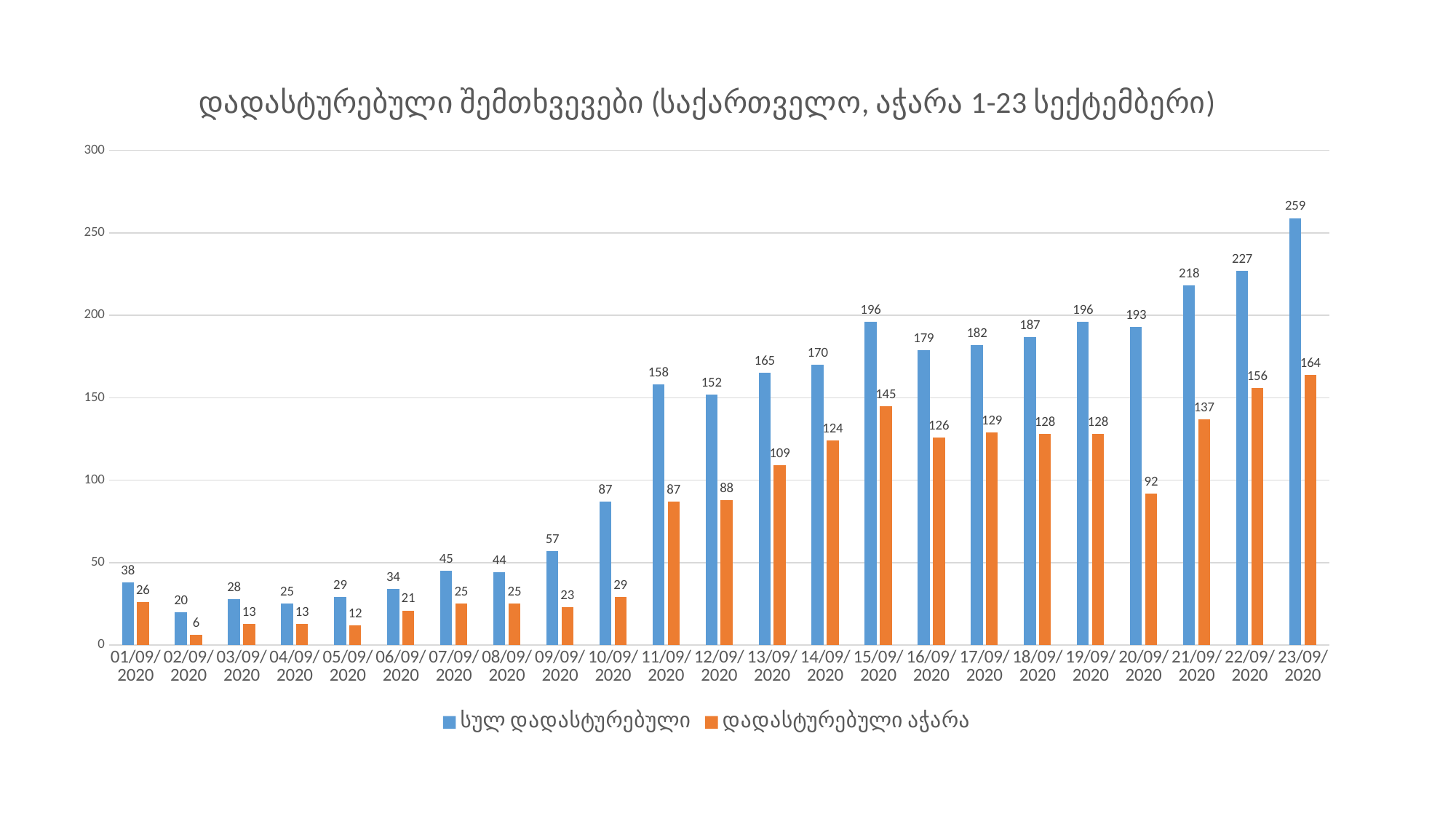
What is the difference between სულ დადასტურებული and დადასტურებული აჭარა on 20/09/2020? 101 What colour are the bars for დადასტურებული აჭარა? orange What type of chart is shown on the slide? bar chart What is the value of სულ დადასტურებული on 23/09/2020? 259 On which date is დადასტურებული აჭარა the lowest? 02/09/2020 How many series does the legend list? 2 What is the value of სულ დადასტურებული on 11/09/2020? 158 What is the value of დადასტურებული აჭარა on 15/09/2020? 145 Which is larger: დადასტურებული აჭარა on 22/09/2020 or on 21/09/2020? 22/09/2020 How many dates are shown on the x axis? 23 On which date is სულ დადასტურებული the highest? 23/09/2020 Does სულ დადასტურებული generally rise or fall from 01/09/2020 to 23/09/2020? rise